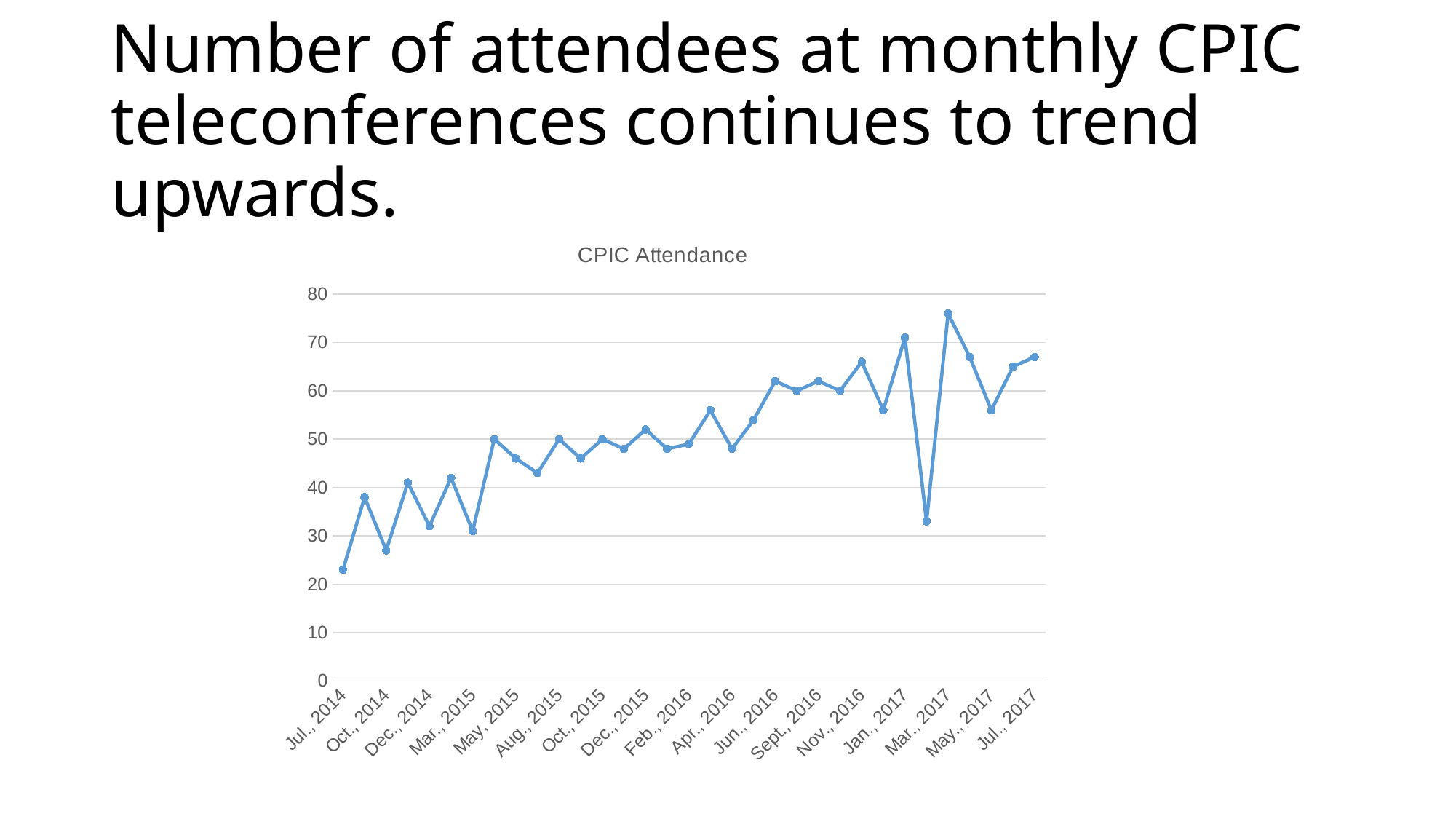
Is the value for Jul., 2014 greater or less than 30? less Which is larger, the value for Mar., 2017 or the value for May, 2017? Mar., 2017 Is the value for May, 2017 greater or less than 60? less Is the value for Nov., 2016 greater or less than 60? greater Which is larger, the value for Jul., 2017 or the value for Jul., 2014? Jul., 2017 Which labeled month has the highest attendance value? Mar., 2017 What is the title of the chart? CPIC Attendance Which labeled month has the lowest attendance value? Jul., 2014 What kind of chart is shown on the slide? line chart Overall, do the attendance values rise or fall from Jul., 2014 to Jul., 2017? rise